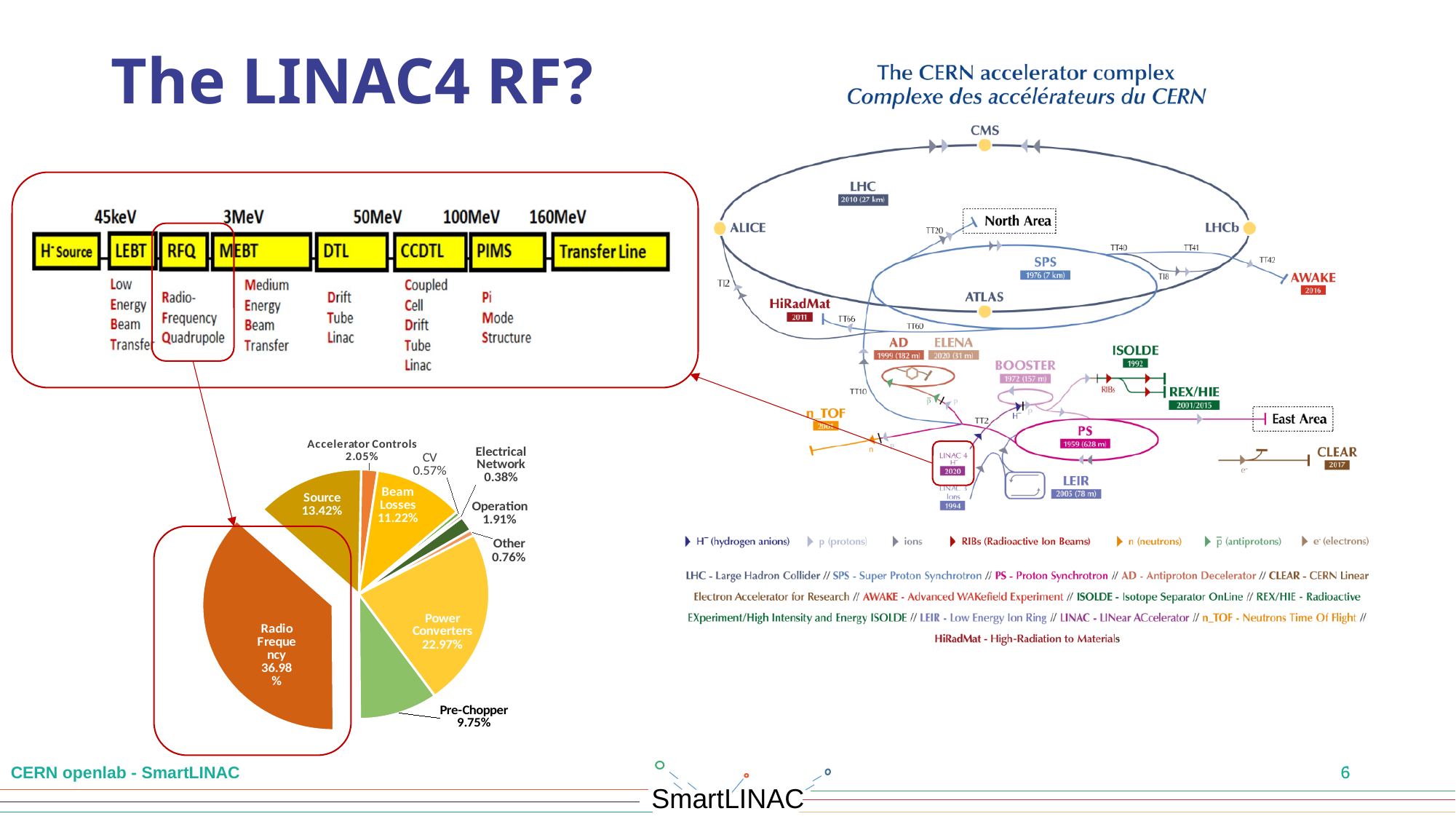
Which slice of the pie chart is pulled out (exploded) from the rest of the pie? Radio Frequency In the pie chart, what share is labelled for Electrical Network? 0.38% In the pie chart, what share is labelled for Power Converters? 22.97% How many slices does the pie chart have? 10 In the pie chart, what share is labelled for Pre-Chopper? 9.75% Which slice of the pie chart is the smallest? Electrical Network What kind of chart is shown at the bottom left of the slide? pie chart In the pie chart, what share is labelled for Radio Frequency? 36.98% Which slice of the pie chart is the largest? Radio Frequency In the pie chart, what is the difference between the Radio Frequency share and the Power Converters share? 14.01% In the pie chart, what is the difference between the Accelerator Controls share and the Operation share? 0.14% In the pie chart, which is larger: Source or Beam Losses? Source